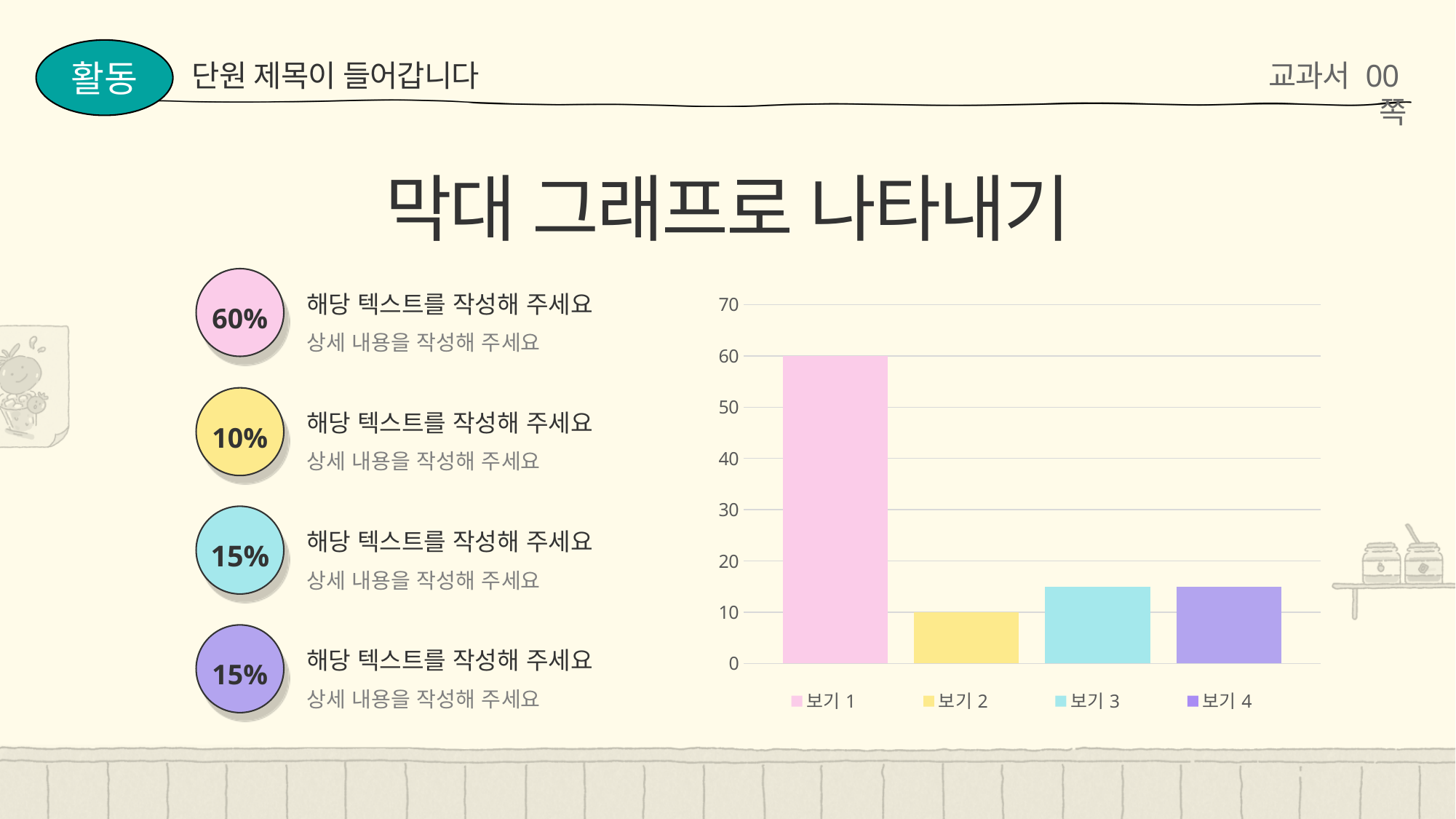
How many entries does the chart legend list? 4 Is the value for 보기 4 greater or less than 10? greater Which is larger, the bar for 보기 1 or the bar for 보기 3? 보기 1 Which category has the lowest bar? 보기 2 What is the value of the bar for 보기 2? 10 What colour is the bar for 보기 1? pink Is the value for 보기 3 greater or less than 20? less How many bars are plotted in the chart? 4 What type of chart is shown on the slide? bar chart Which category has the highest bar? 보기 1 What is the difference between the values for 보기 1 and 보기 2? 50 What is the value of the bar for 보기 1? 60